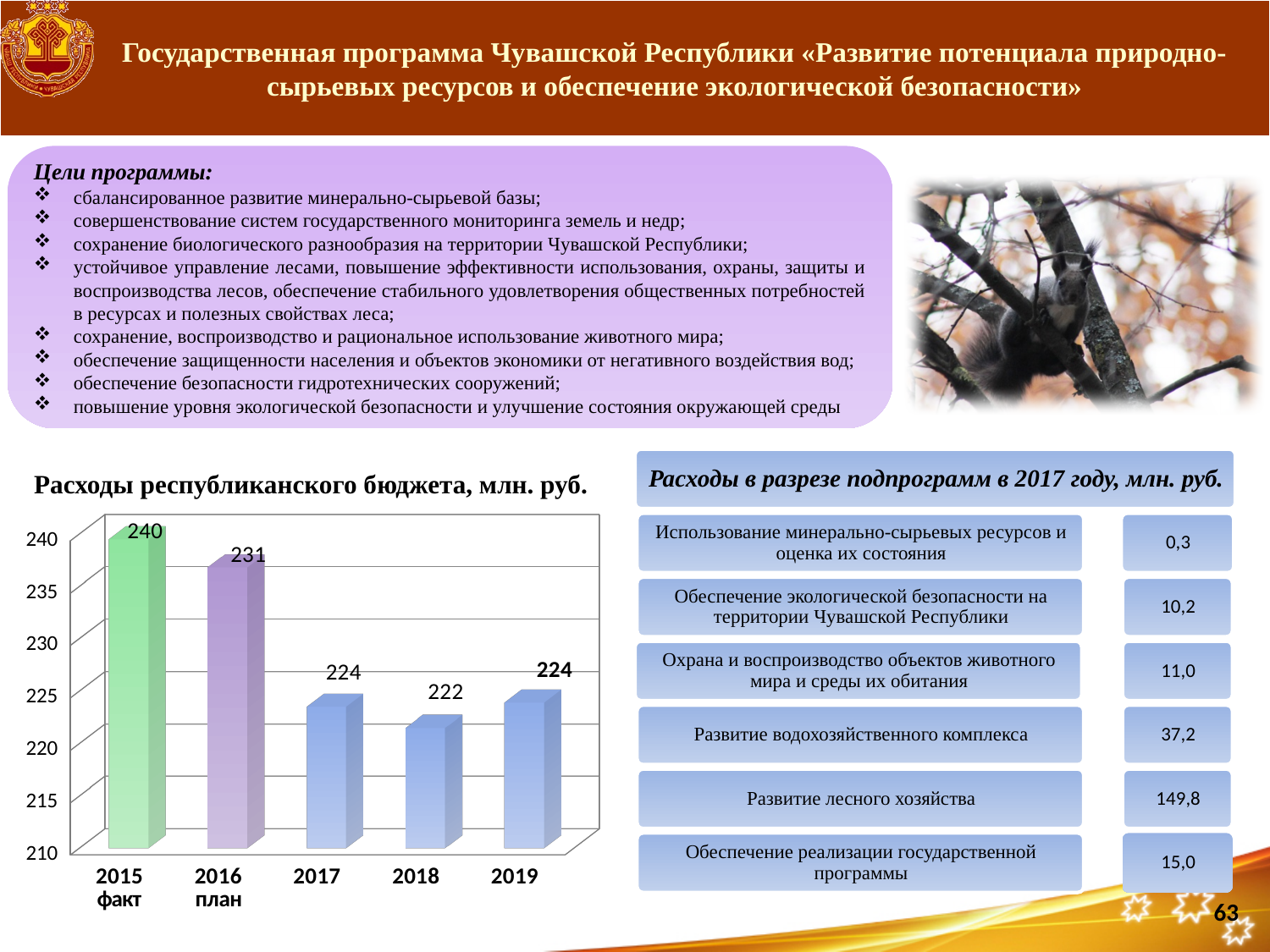
What is the difference between the values for 2015 факт and 2016 план in the chart 'Расходы республиканского бюджета, млн. руб.'? 9 Which year has the highest value in the chart 'Расходы республиканского бюджета, млн. руб.'? 2015 факт What is the difference between the values for 2017 and 2018 in the chart 'Расходы республиканского бюджета, млн. руб.'? 2 Which is larger in the chart 'Расходы республиканского бюджета, млн. руб.': the value for 2016 план or the value for 2019? 2016 план What kind of chart is 'Расходы республиканского бюджета, млн. руб.'? bar chart What is the value for 2016 план in the chart 'Расходы республиканского бюджета, млн. руб.'? 231 Which year has the lowest value in the chart 'Расходы республиканского бюджета, млн. руб.'? 2018 How many years are shown on the x axis of the chart 'Расходы республиканского бюджета, млн. руб.'? 5 Is the value for 2017 in the chart 'Расходы республиканского бюджета, млн. руб.' greater or less than 230? less What is the value for 2015 факт in the chart 'Расходы республиканского бюджета, млн. руб.'? 240 What is the title of the chart on the lower left of the slide? Расходы республиканского бюджета, млн. руб. What is the value for 2018 in the chart 'Расходы республиканского бюджета, млн. руб.'? 222